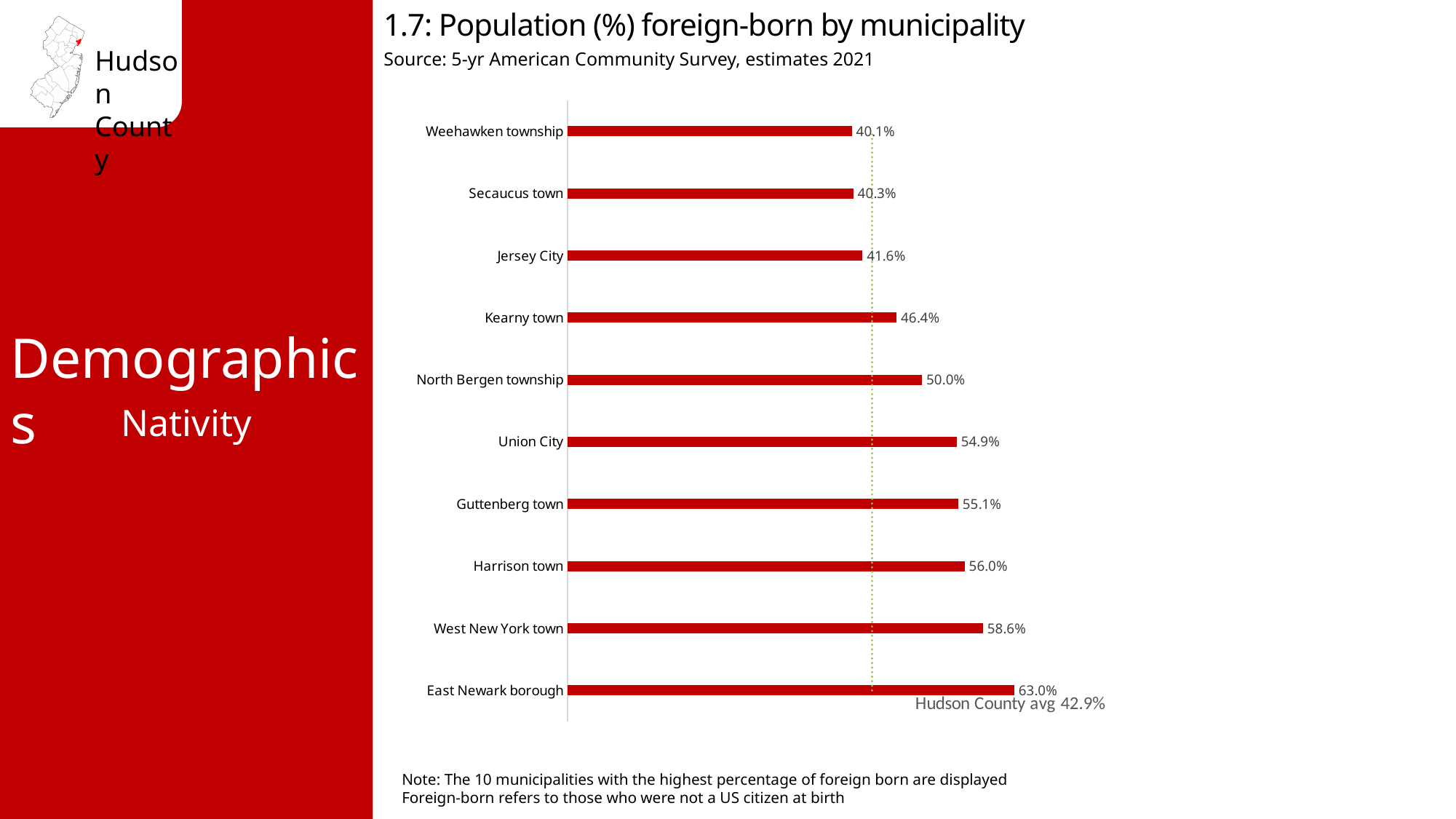
What is the difference in foreign-born percentage between Harrison town and Kearny town? 9.6% What is the foreign-born population percentage for West New York town? 58.6% What is the difference in foreign-born percentage between East Newark borough and Weehawken township? 22.9% What is the Hudson County average foreign-born percentage shown on the chart? 42.9% How many municipalities are shown on the chart? 10 What is the foreign-born population percentage for Jersey City? 41.6% What type of chart is used to show the foreign-born population by municipality? Bar chart Which municipality has the lowest percentage of foreign-born population on the chart? Weehawken township What is the foreign-born population percentage for North Bergen township? 50.0% Which municipality has the highest percentage of foreign-born population? East Newark borough Which has a higher foreign-born percentage, Union City or Kearny town? Union City What is the source of the data shown in the chart? 5-yr American Community Survey, estimates 2021